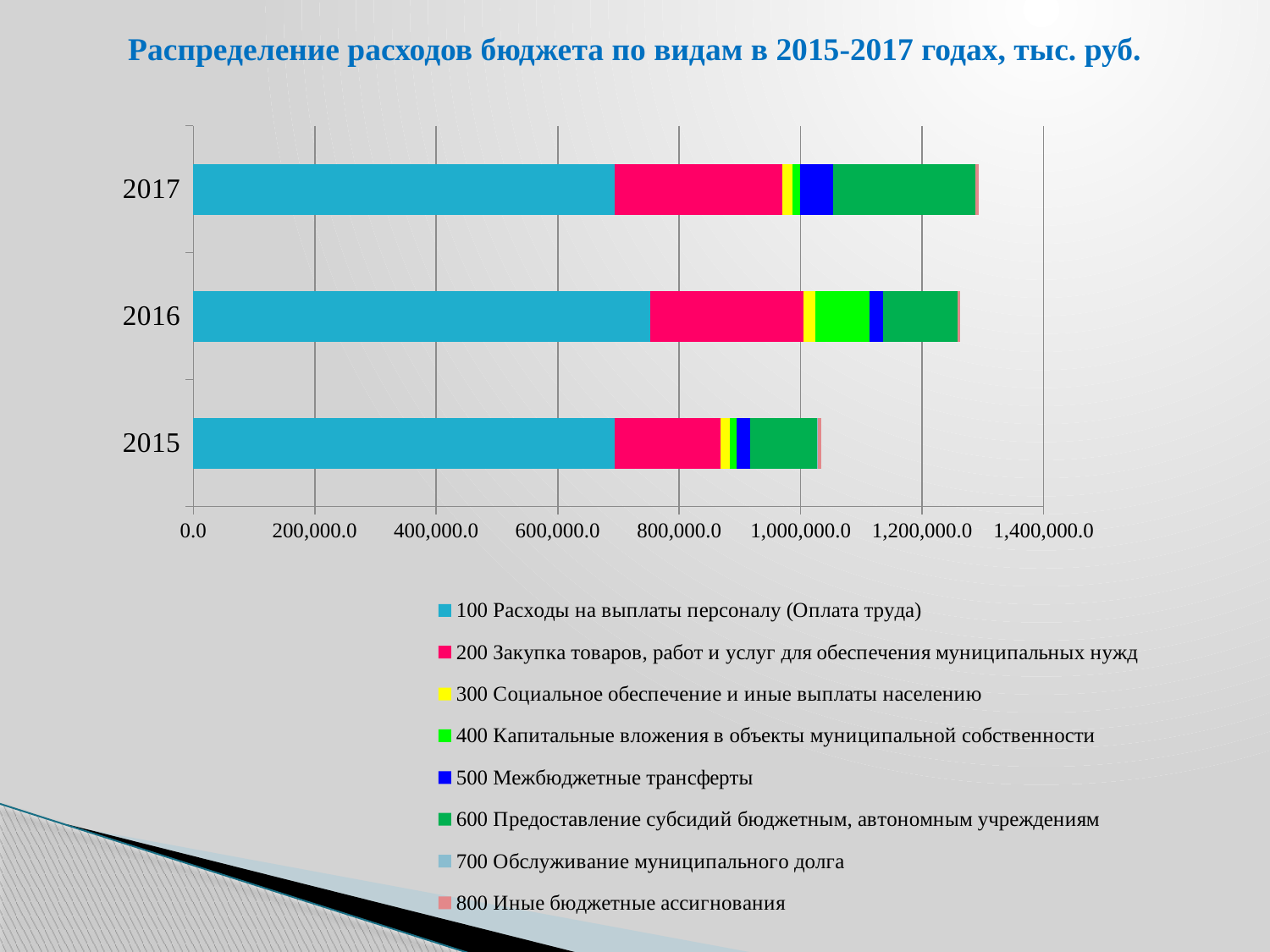
What kind of chart is shown on the slide? stacked bar chart Is the value of the '100 Расходы на выплаты персоналу (Оплата труда)' segment for 2017 greater or less than 800,000.0? less How many years (categories) are plotted on the chart? 3 Is the total bar for 2017 greater or less than 1,200,000.0? greater Which legend entry is shown in yellow? 300 Социальное обеспечение и иные выплаты населению Is the value of the '100 Расходы на выплаты персоналу (Оплата труда)' segment for 2016 greater or less than 600,000.0? greater Which year has the larger total bar, 2016 or 2015? 2016 How many series does the legend list? 8 Which year has the shortest total bar? 2015 What is the title of the chart? Распределение расходов бюджета по видам в 2015-2017 годах, тыс. руб.